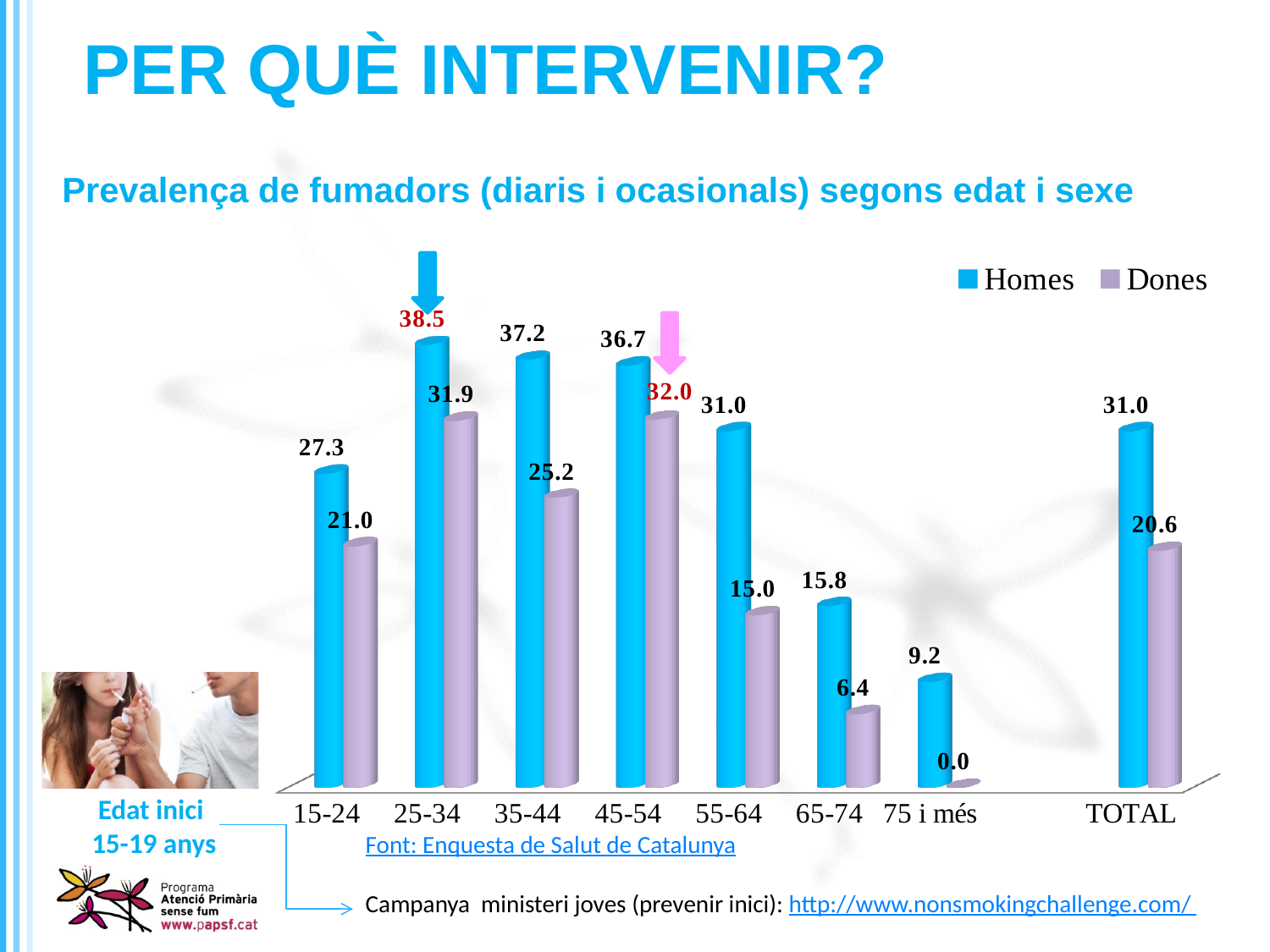
What is the value for Dones in the TOTAL category? 20.6 Which age group has the highest value for Homes? 25-34 What is the value for Dones in the 45-54 age group? 32.0 How many categories are shown on the x axis? 8 What is the value for Homes in the 25-34 age group? 38.5 Do the Homes values rise or fall from the 25-34 age group to the 75 i més age group? Fall How many series does the legend list? 2 What kind of chart is shown on the slide? Bar chart Which age group has the lowest value for Dones? 75 i més What is the difference between Homes and Dones in the 15-24 age group? 6.3 Which is larger in the 65-74 age group, Homes or Dones? Homes What is the source cited below the chart? Enquesta de Salut de Catalunya